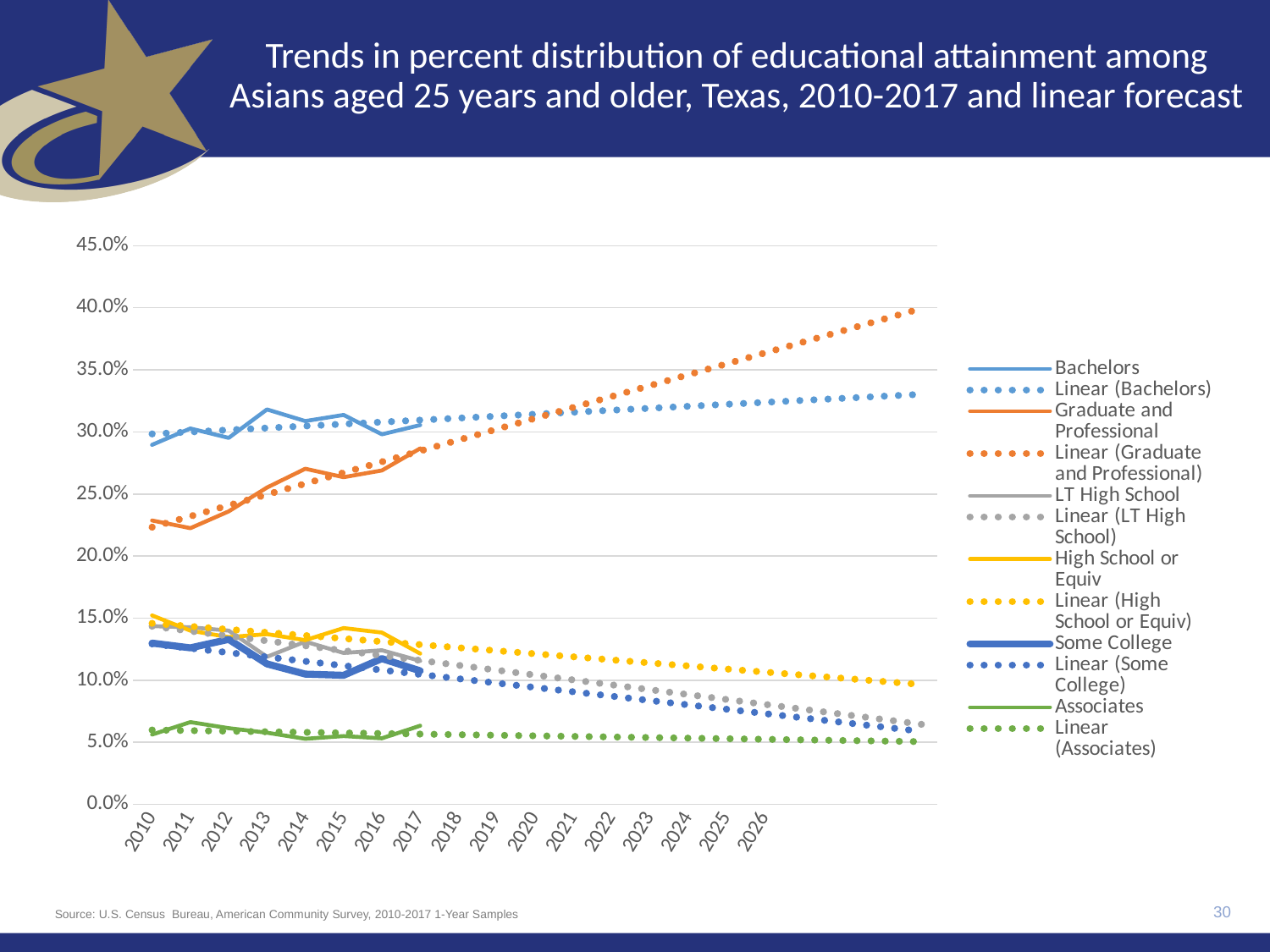
What is the source cited at the bottom of the slide? U.S. Census Bureau, American Community Survey, 2010-2017 1-Year Samples Is the value for Associates in 2010 greater or less than 5.0%? greater Does the Linear (LT High School) forecast line rise or fall from 2010 to 2026? Fall What kind of chart is shown on the slide? Line chart Which series has the highest value in 2017? Bachelors In 2010, which is larger: the value for Bachelors or the value for Graduate and Professional? Bachelors How many years are labelled along the x axis of the chart? 17 Is the Linear (Bachelors) forecast value for 2026 greater or less than 30.0%? greater Does the Linear (Graduate and Professional) forecast line rise or fall from 2010 to 2026? Rise Is the value for Graduate and Professional in 2010 greater or less than 25.0%? less Which series has the lowest value in 2010? Associates How many entries does the chart's legend list? 12